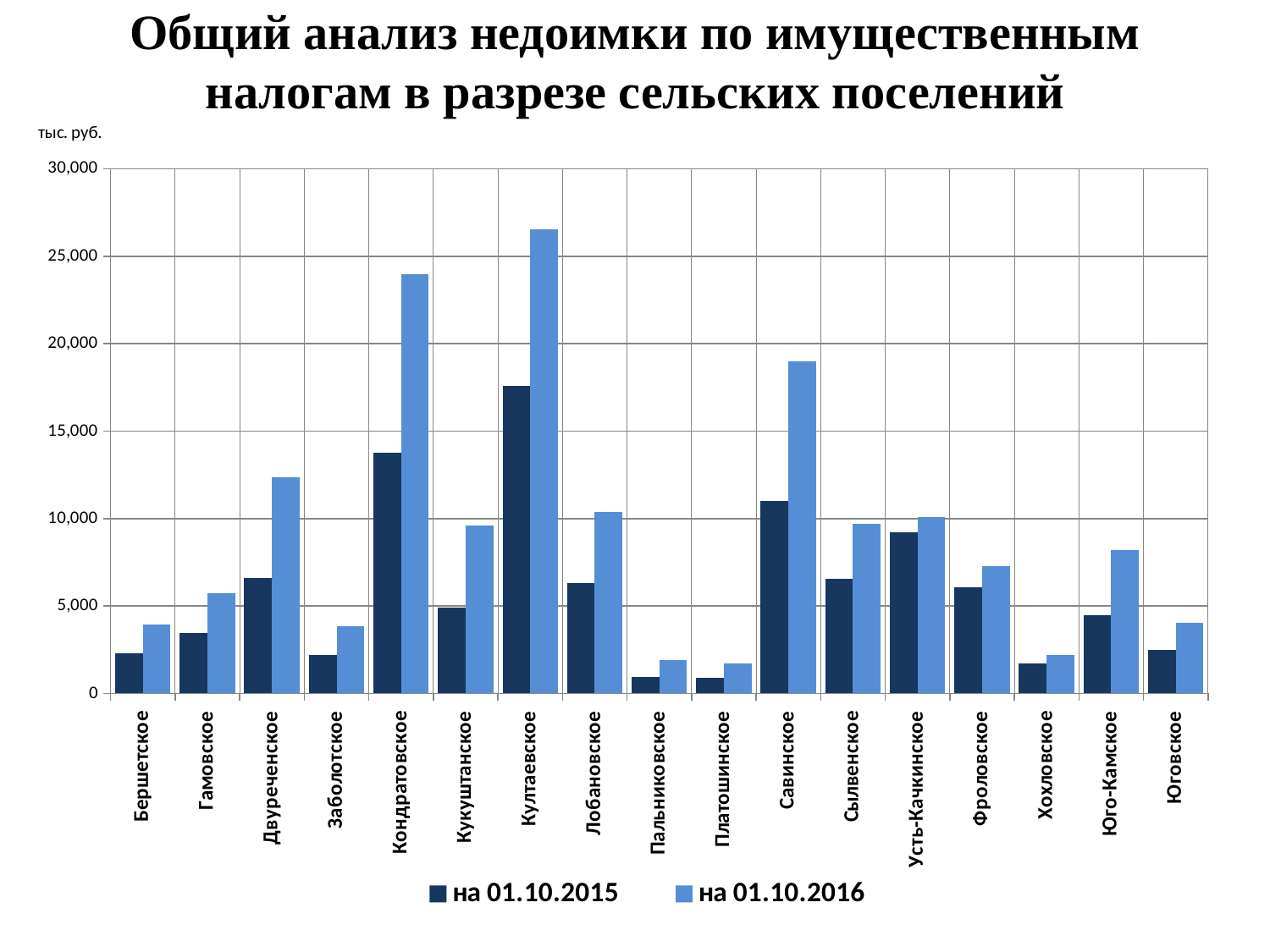
What kind of chart is shown on the slide? bar chart Is the value for Савинское in the series 'на 01.10.2016' greater or less than 20,000? less Which settlement has the highest value for the series 'на 01.10.2016'? Култаевское How many settlements (categories) are shown on the x axis? 17 Is the value for Кондратовское in the series 'на 01.10.2016' greater or less than 20,000? greater How many series does the legend list? 2 Is the value for Юго-Камское in the series 'на 01.10.2016' greater or less than 5,000? greater Which settlement has the highest value for the series 'на 01.10.2015'? Култаевское For Фроловское, which series has the larger value: 'на 01.10.2015' or 'на 01.10.2016'? на 01.10.2016 In the series 'на 01.10.2016', which is larger: Кондратовское or Савинское? Кондратовское What unit is indicated above the vertical axis? тыс. руб.